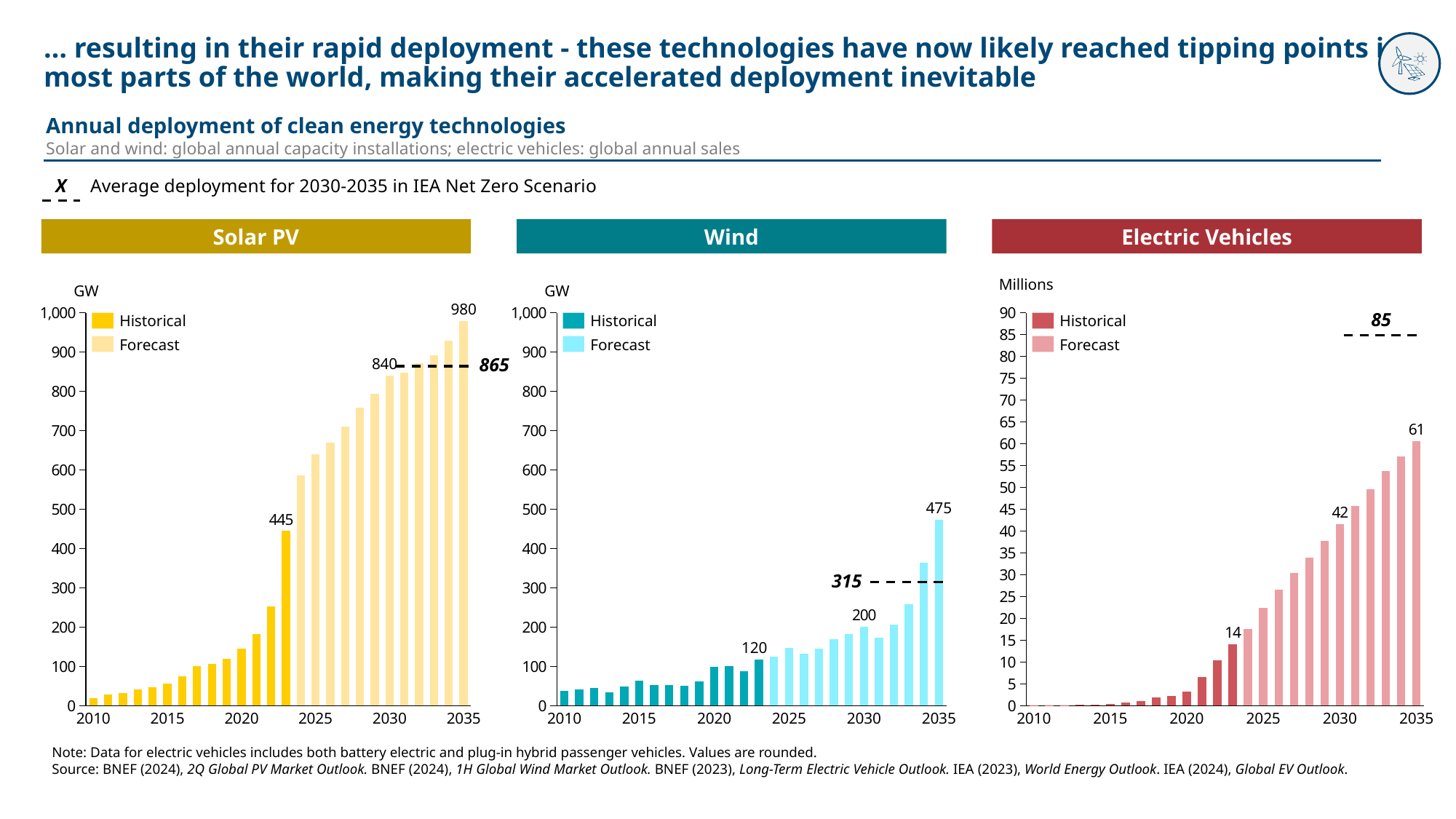
In the Electric Vehicles chart, what is the forecast value for 2035? 61 How many series does the legend of the Wind chart list? 2 In the Electric Vehicles chart, what is the value for 2023? 14 In the Solar PV chart, is the 2035 forecast value larger or smaller than the IEA Net Zero Scenario average of 865? larger In the Solar PV chart, what is the difference between the 2035 value and the 2030 value? 140 In the Wind chart, what is the forecast value for 2035? 475 In the Electric Vehicles chart, what is the difference between the 2035 value and the 2030 value? 19 What kind of chart is the Electric Vehicles chart? bar chart In the Wind chart, what is the difference between the 2035 value and the 2023 value? 355 In the Solar PV chart, what is the value for 2023? 445 In the Solar PV chart, is the value for 2020 greater or less than 200? less In the Solar PV chart, what is the forecast value for 2035? 980